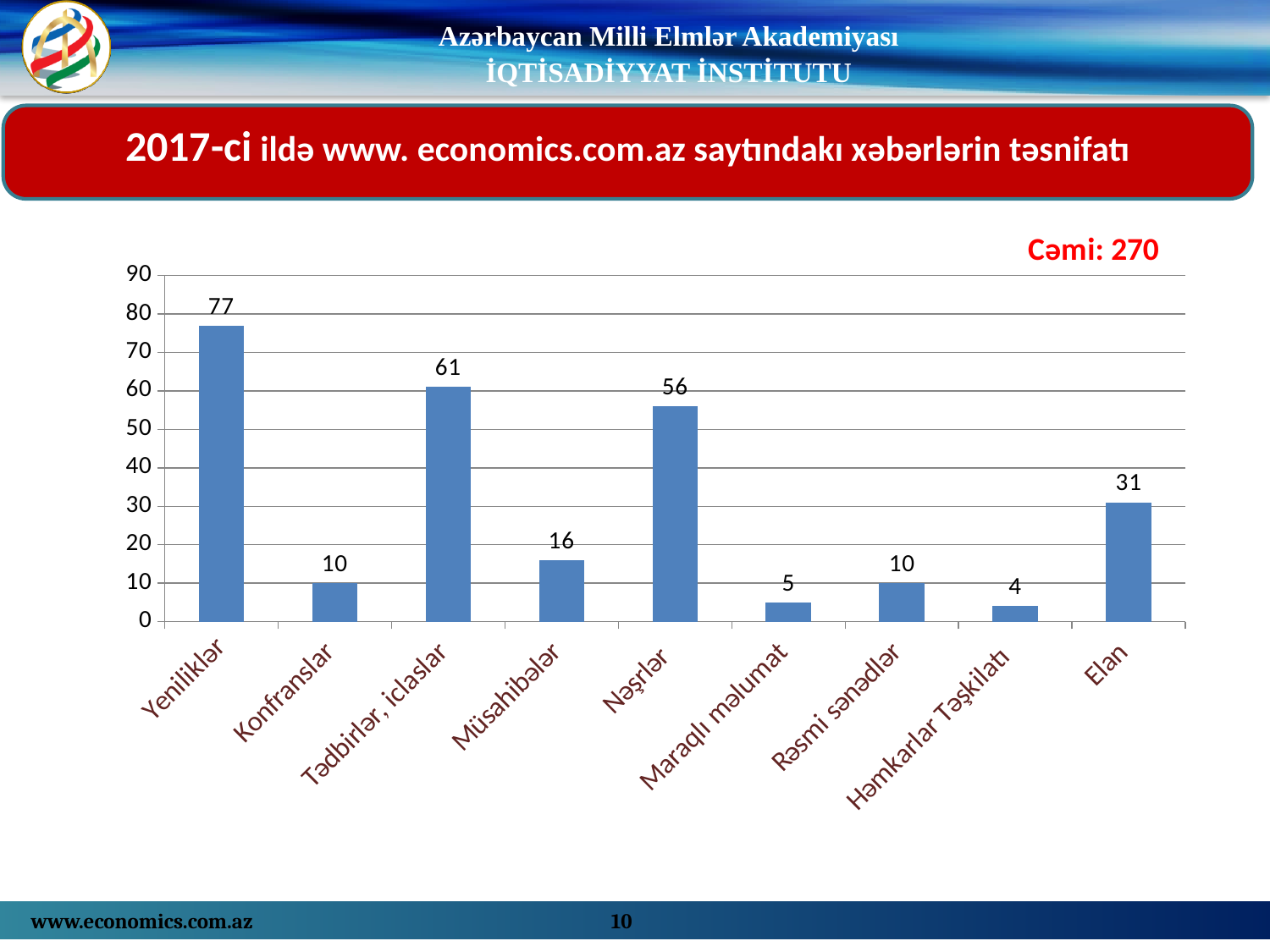
Which is larger, the value for Müsahibələr or the value for Elan? Elan What is the difference between the values for Maraqlı məlumat and Həmkarlar Təşkilatı? 1 What is the value for Nəşrlər? 56 What kind of chart is shown on the slide? Bar chart Which category has the lowest value? Həmkarlar Təşkilatı What total is stated above the chart (Cəmi)? 270 What is the difference between the values for Yeniliklər and Tədbirlər, iclaslar? 16 What is the value for Elan? 31 How many categories are shown on the x axis? 9 What is the value for Tədbirlər, iclaslar? 61 Which category has the highest value? Yeniliklər What is the value for Yeniliklər? 77